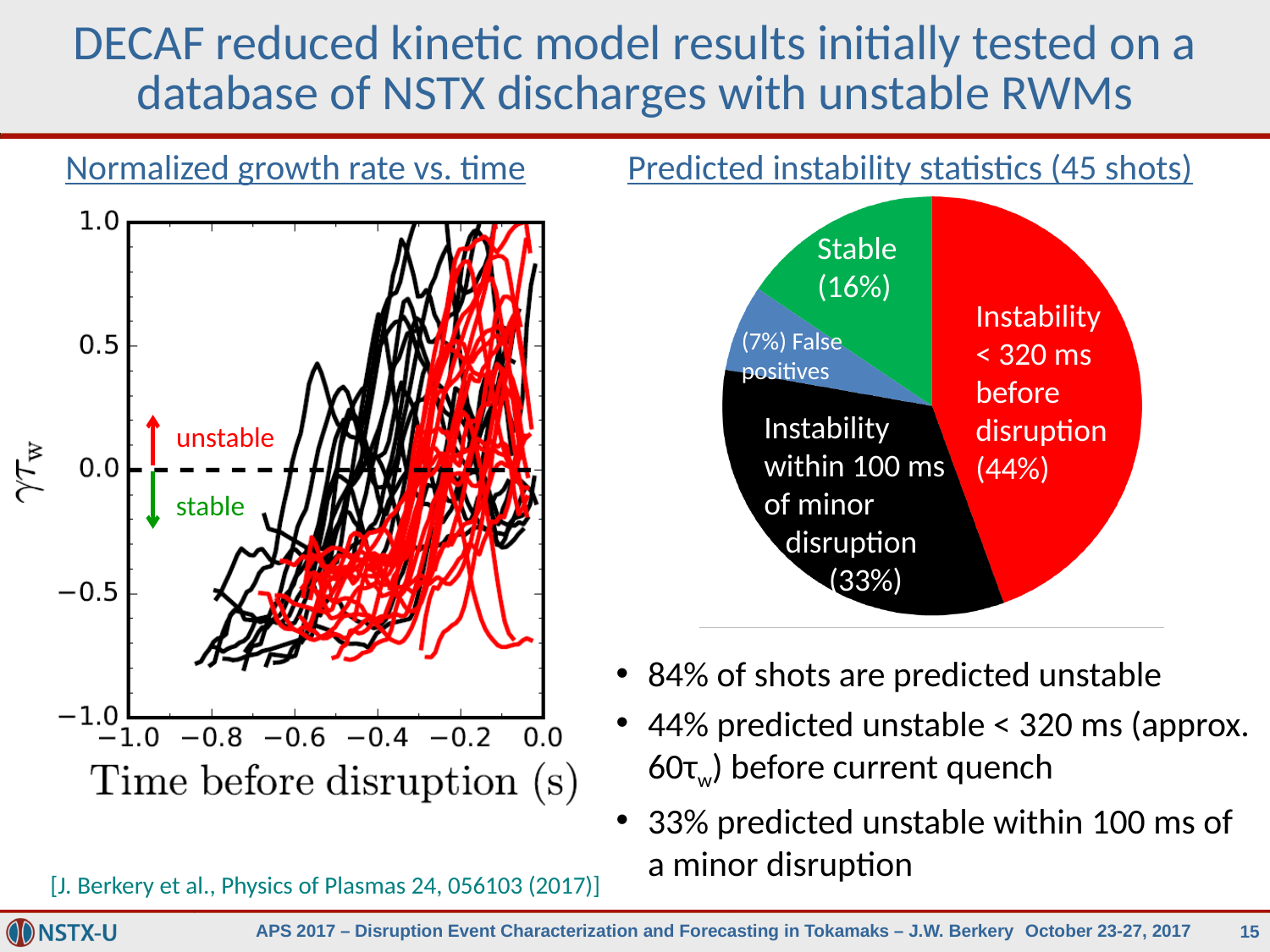
In the 'Predicted instability statistics (45 shots)' pie chart, how many slices are there? 4 In the 'Predicted instability statistics (45 shots)' pie chart, what colour is the 'Stable' slice? green In the 'Predicted instability statistics (45 shots)' pie chart, what percentage is given for 'False positives'? 7% In the 'Normalized growth rate vs. time' chart on the left, what is the x-axis label? Time before disruption (s) In the 'Predicted instability statistics (45 shots)' pie chart, what percentage is given for 'Instability < 320 ms before disruption'? 44% In the 'Predicted instability statistics (45 shots)' pie chart, what is the difference in percentage points between the 'Instability < 320 ms before disruption' slice and the 'Stable' slice? 28 In the 'Predicted instability statistics (45 shots)' pie chart, what percentage is given for 'Instability within 100 ms of minor disruption'? 33% In the 'Predicted instability statistics (45 shots)' pie chart, what share of shots is labelled 'Stable'? 16% In the 'Predicted instability statistics (45 shots)' pie chart, which slice is the largest? Instability < 320 ms before disruption In the 'Predicted instability statistics (45 shots)' pie chart, which slice is the smallest? False positives In the 'Predicted instability statistics (45 shots)' pie chart, which is larger: the 'Stable' slice or the 'False positives' slice? Stable In the 'Predicted instability statistics (45 shots)' chart, what kind of chart is shown? pie chart